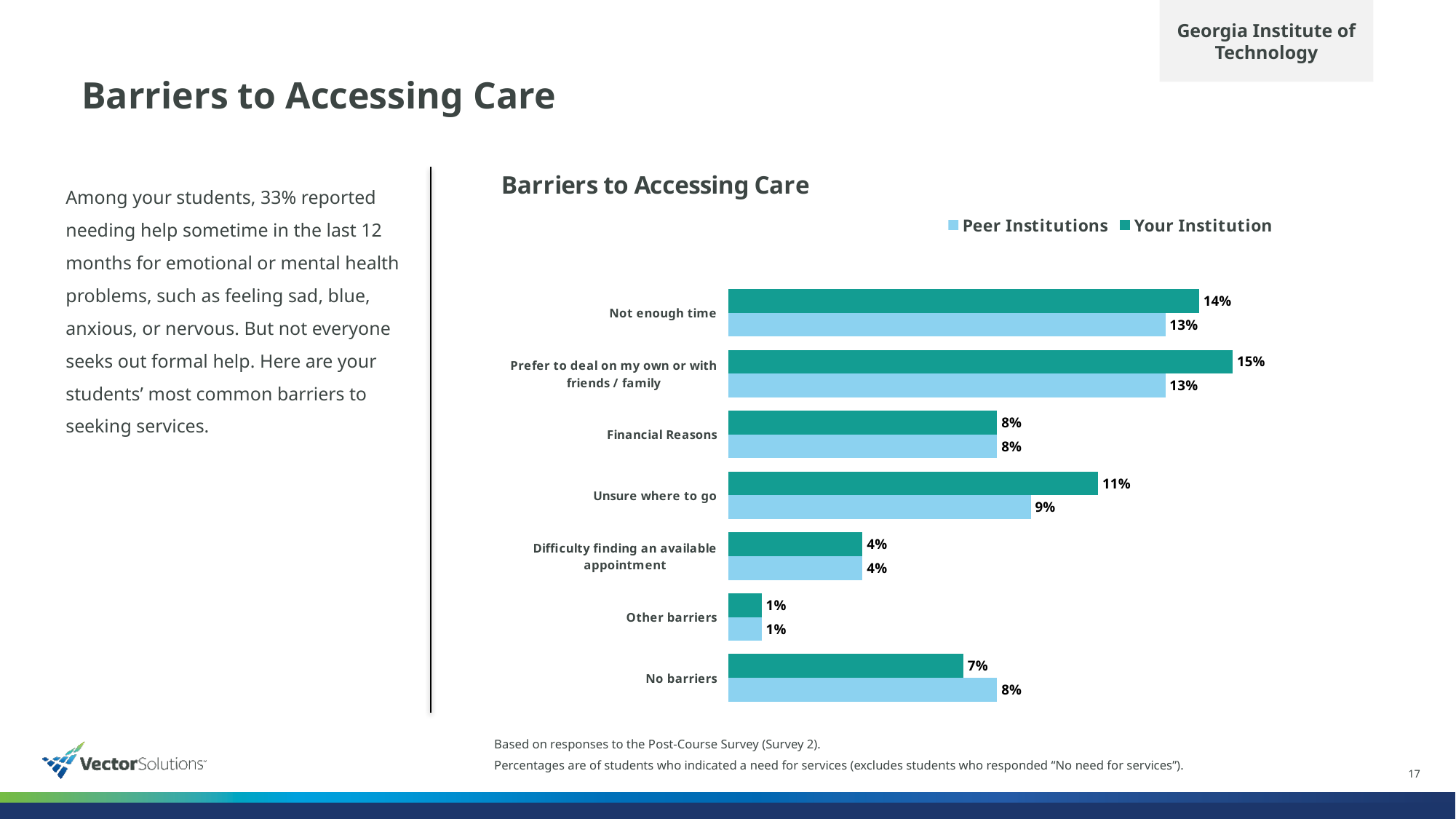
How many series does the legend list? 2 What is the difference between Your Institution and Peer Institutions for "Unsure where to go"? 2% What is the difference between Your Institution and Peer Institutions for "Prefer to deal on my own or with friends / family"? 2% What kind of chart is shown on the slide? Bar chart What is the value for Your Institution for "Not enough time"? 14% For "No barriers", which is larger: Peer Institutions or Your Institution? Peer Institutions What is the value for Your Institution for "No barriers"? 7% How many barrier categories are shown in the chart? 7 What is the value for Peer Institutions for "Unsure where to go"? 9% What is the title of the chart? Barriers to Accessing Care Which category has the lowest value for Peer Institutions? Other barriers Which category has the highest value for Your Institution? Prefer to deal on my own or with friends / family